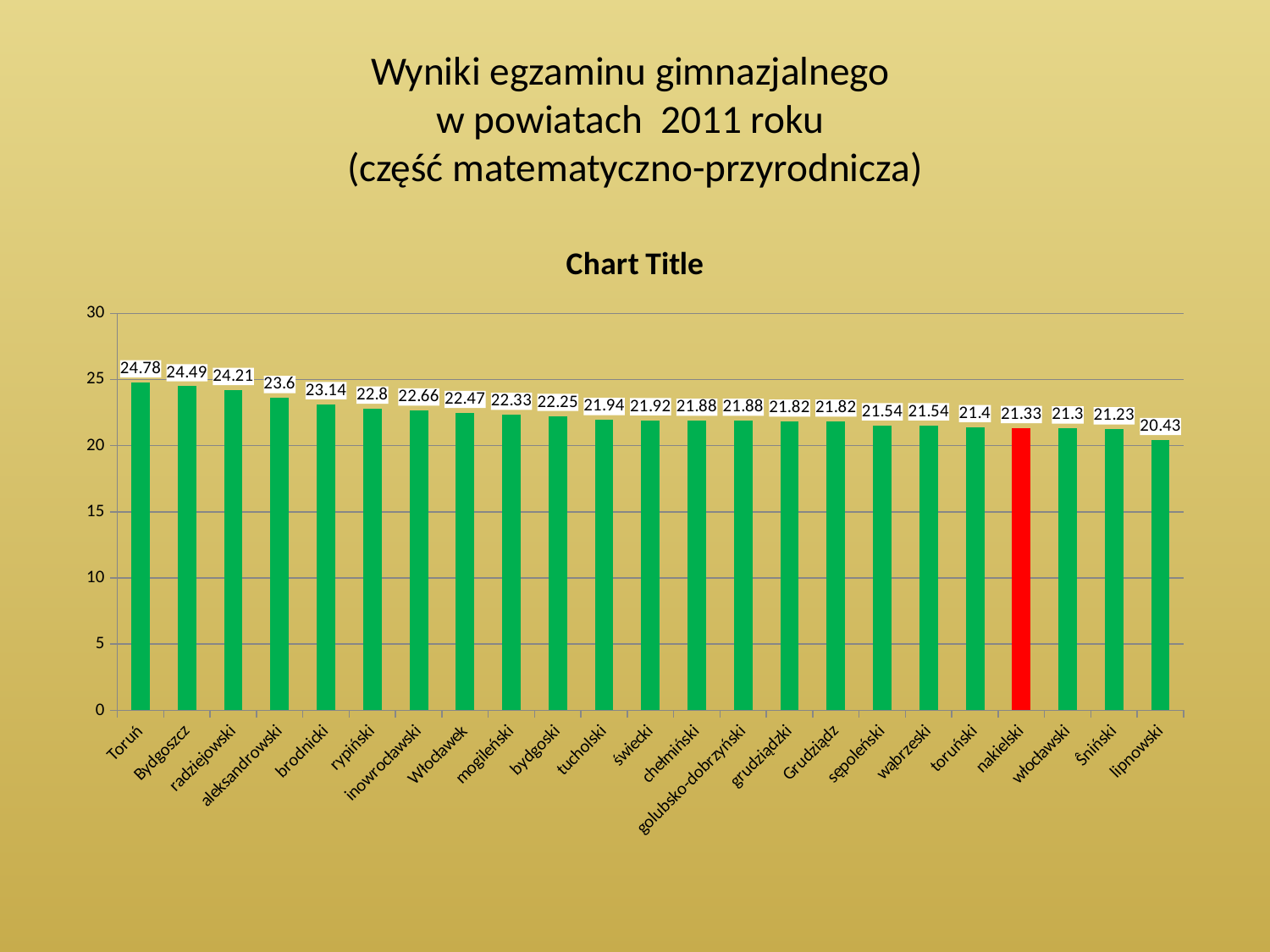
What is the difference between the values for Bydgoszcz and Włocławek? 2.02 What is the value for lipnowski? 20.43 What is the value for brodnicki? 23.14 What is the difference between the values for Toruń and lipnowski? 4.35 What is the value for nakielski? 21.33 What is the value for Toruń? 24.78 What kind of chart is this? bar chart Which category's bar is coloured red instead of green? nakielski Which category has the highest value? Toruń Which category has the lowest value? lipnowski How many categories are shown on the x axis? 23 Which is larger, the value for radziejowski or the value for rypiński? radziejowski